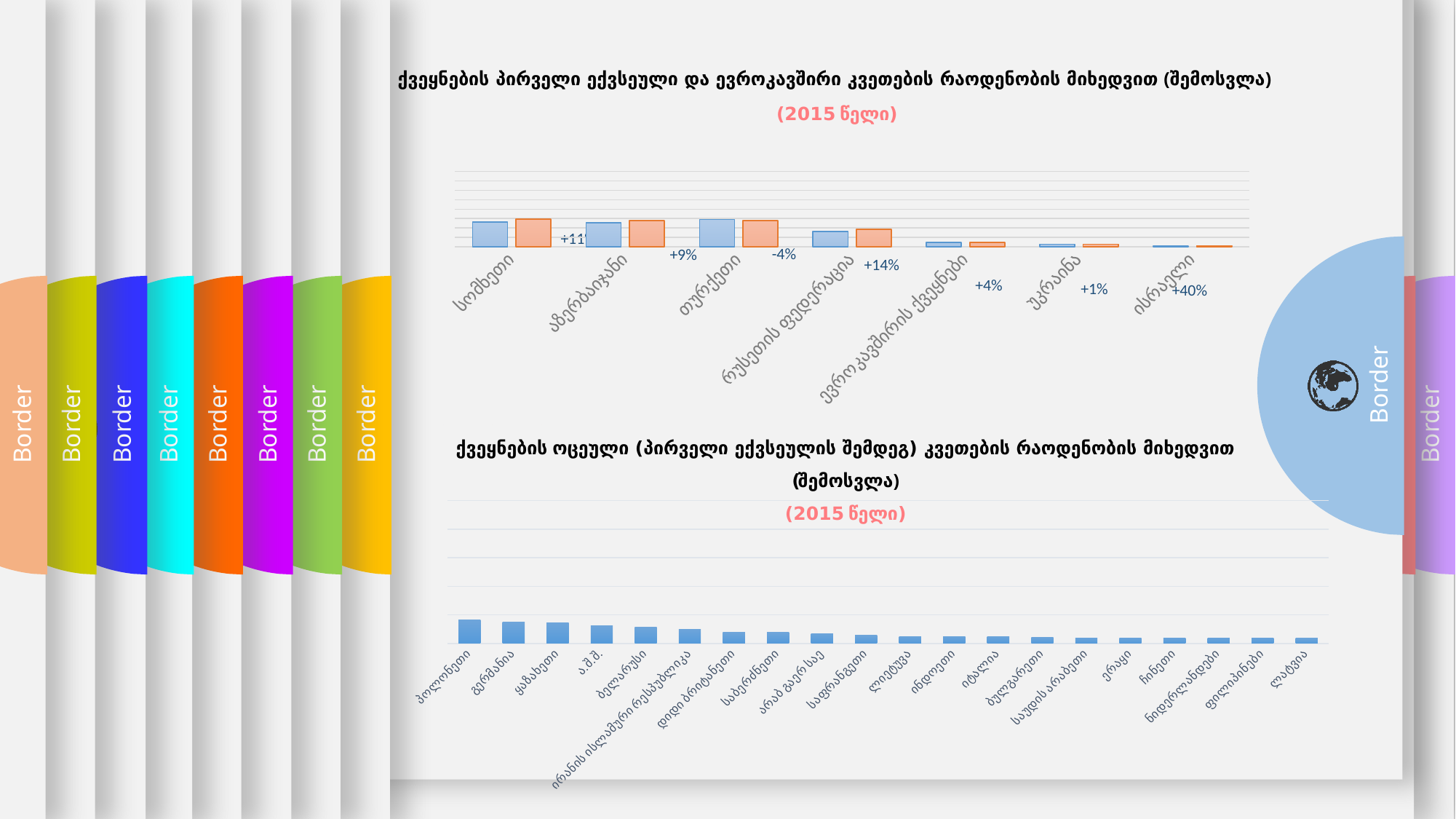
What kind of chart is the bottom chart on the slide? bar chart How many categories are shown on the x axis of the top chart? 7 How many data series are plotted in the bottom chart? 1 In the bottom chart, do the bar values rise or fall from left to right along the x axis? fall In the bottom chart, which category has the highest bar? პოლონეთი In the top chart, which has the larger blue bar: სომხეთი or უკრაინა? სომხეთი In the bottom chart, which has the larger bar: გერმანია or ინდოეთი? გერმანია In the top chart, which category has the lowest bars? ისრაელი How many data series are plotted in the top chart? 2 How many categories are shown on the x axis of the bottom chart? 20 What kind of chart is the top chart on the slide? bar chart In the top chart, what percentage label is shown next to the bars for ისრაელი? +40%